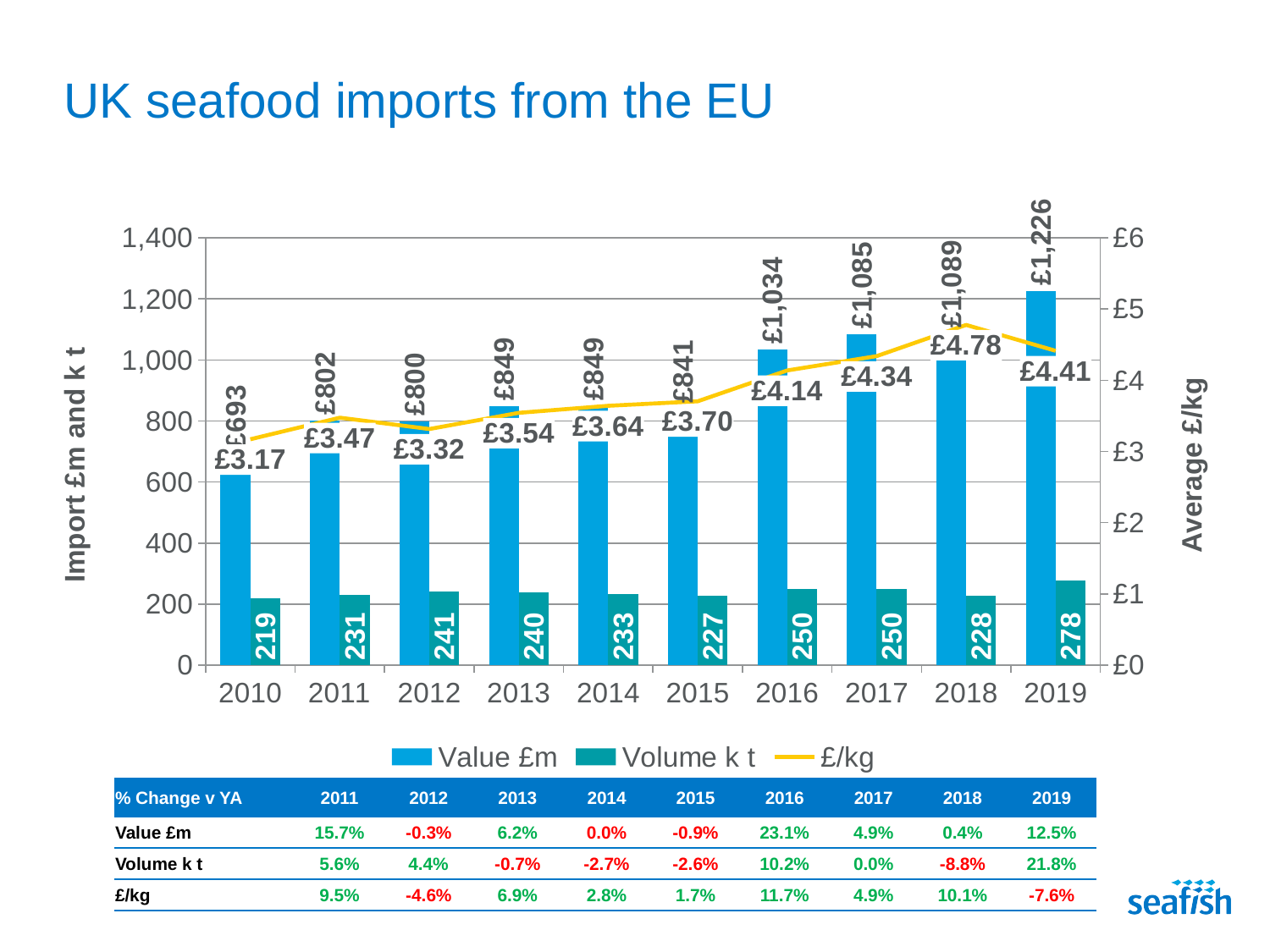
Is the Value £m bar for 2017 greater or less than 1,000? greater How many series does the legend list? 3 What is the title of the right-hand vertical axis? Average £/kg Which is larger, the £/kg value for 2018 or for 2019? 2018 How many years are shown on the x axis? 10 Which year has the highest Volume k t? 2019 What is the £/kg value for 2018? £4.78 What is the difference in Value £m between 2019 and 2018? £137 What is the Volume k t for 2016? 250 What kind of chart is this? Combined bar and line chart What is the Value £m for 2019? £1,226 Which year has the lowest Value £m? 2010